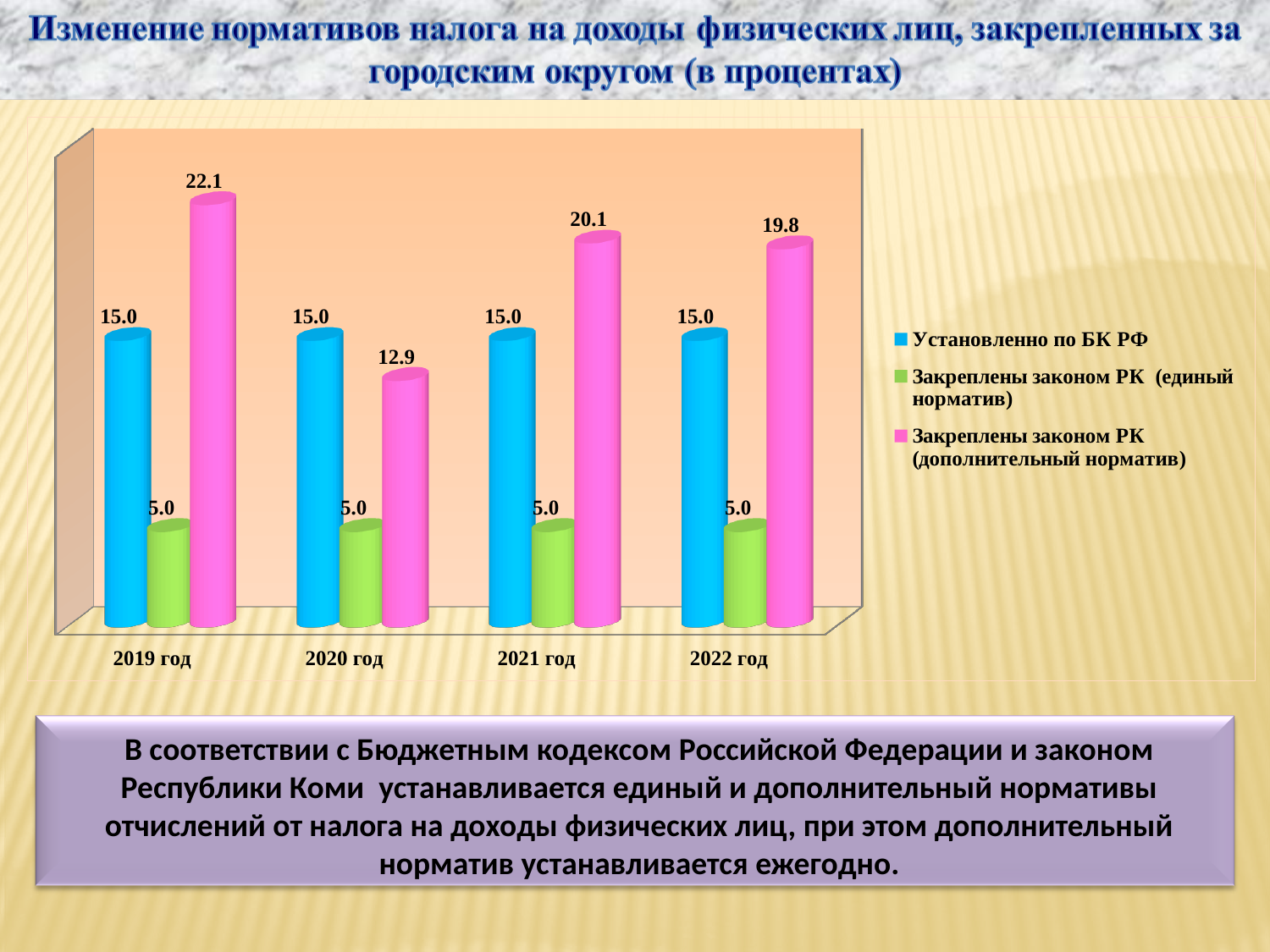
What is the value of the pink series (Закреплены законом РК (дополнительный норматив)) for 2020 год? 12.9 What is the value of the pink series (Закреплены законом РК (дополнительный норматив)) for 2019 год? 22.1 What colour represents the series Установленно по БК РФ in the legend? Blue Which is larger in 2020 год: the blue series (Установленно по БК РФ) or the pink series (дополнительный норматив)? Установленно по БК РФ What is the value of the green series (Закреплены законом РК (единый норматив)) for 2022 год? 5.0 How many years are shown on the x axis? 4 In which year is the pink series (дополнительный норматив) highest? 2019 год How many series does the legend list? 3 In which year is the pink series (дополнительный норматив) lowest? 2020 год What is the value of the blue series (Установленно по БК РФ) for 2021 год? 15.0 What is the difference between the pink series values for 2019 год and 2020 год? 9.2 What kind of chart is shown on the slide? Bar chart